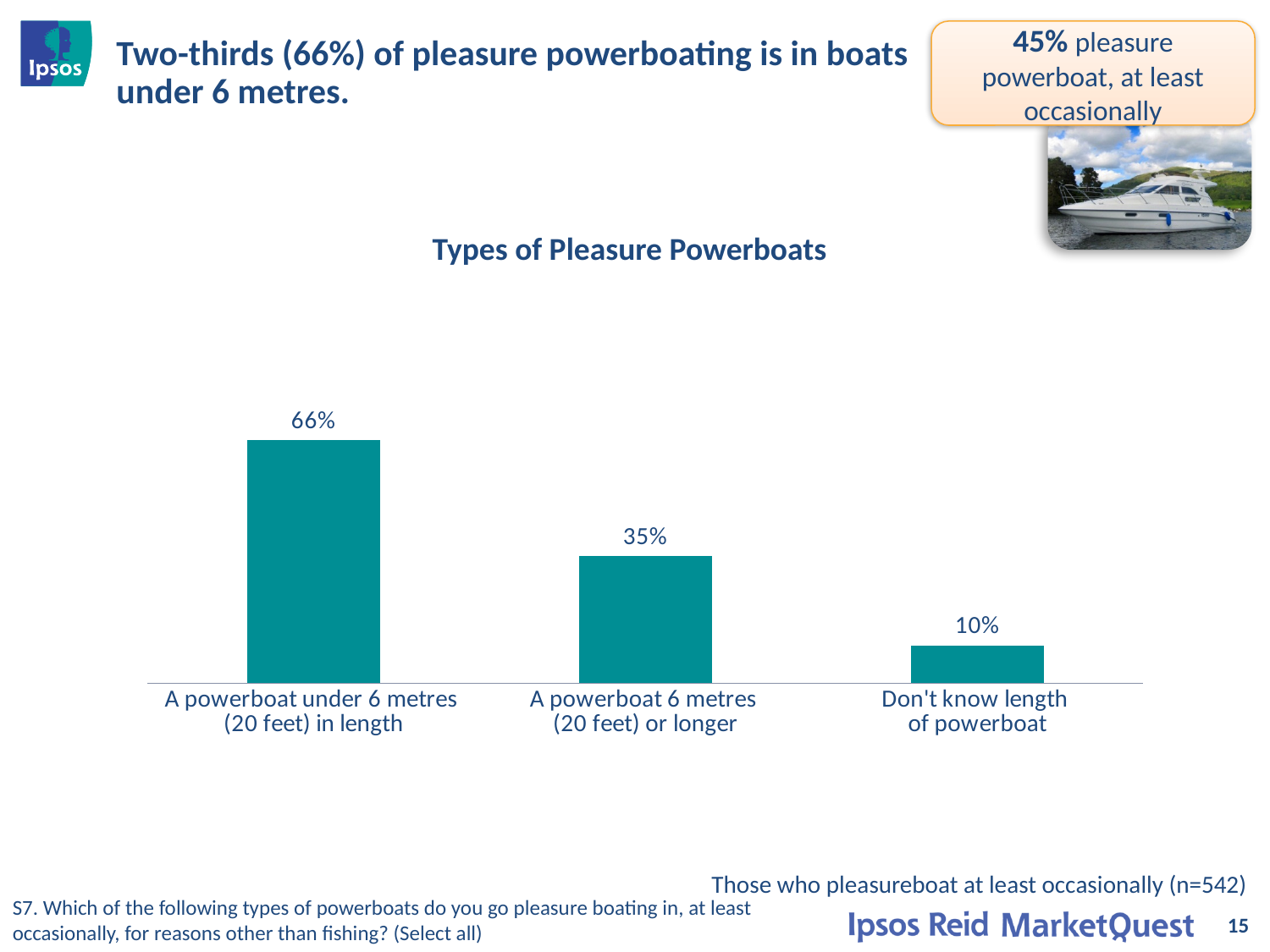
Which category has the highest value? A powerboat under 6 metres (20 feet) in length What is the difference between the values for 'A powerboat under 6 metres (20 feet) in length' and 'A powerboat 6 metres (20 feet) or longer'? 31% What is the value for 'Don't know length of powerboat'? 10% What is the difference between the values for 'A powerboat 6 metres (20 feet) or longer' and 'Don't know length of powerboat'? 25% What is the value for 'A powerboat 6 metres (20 feet) or longer'? 35% What kind of chart is shown on the slide? Bar chart What is the title of the chart? Types of Pleasure Powerboats Do the values rise or fall from left to right across the categories? Fall Which is larger: the value for 'A powerboat 6 metres (20 feet) or longer' or the value for 'Don't know length of powerboat'? A powerboat 6 metres (20 feet) or longer How many categories are shown in the chart? 3 What is the value for 'A powerboat under 6 metres (20 feet) in length'? 66% Which category has the lowest value? Don't know length of powerboat